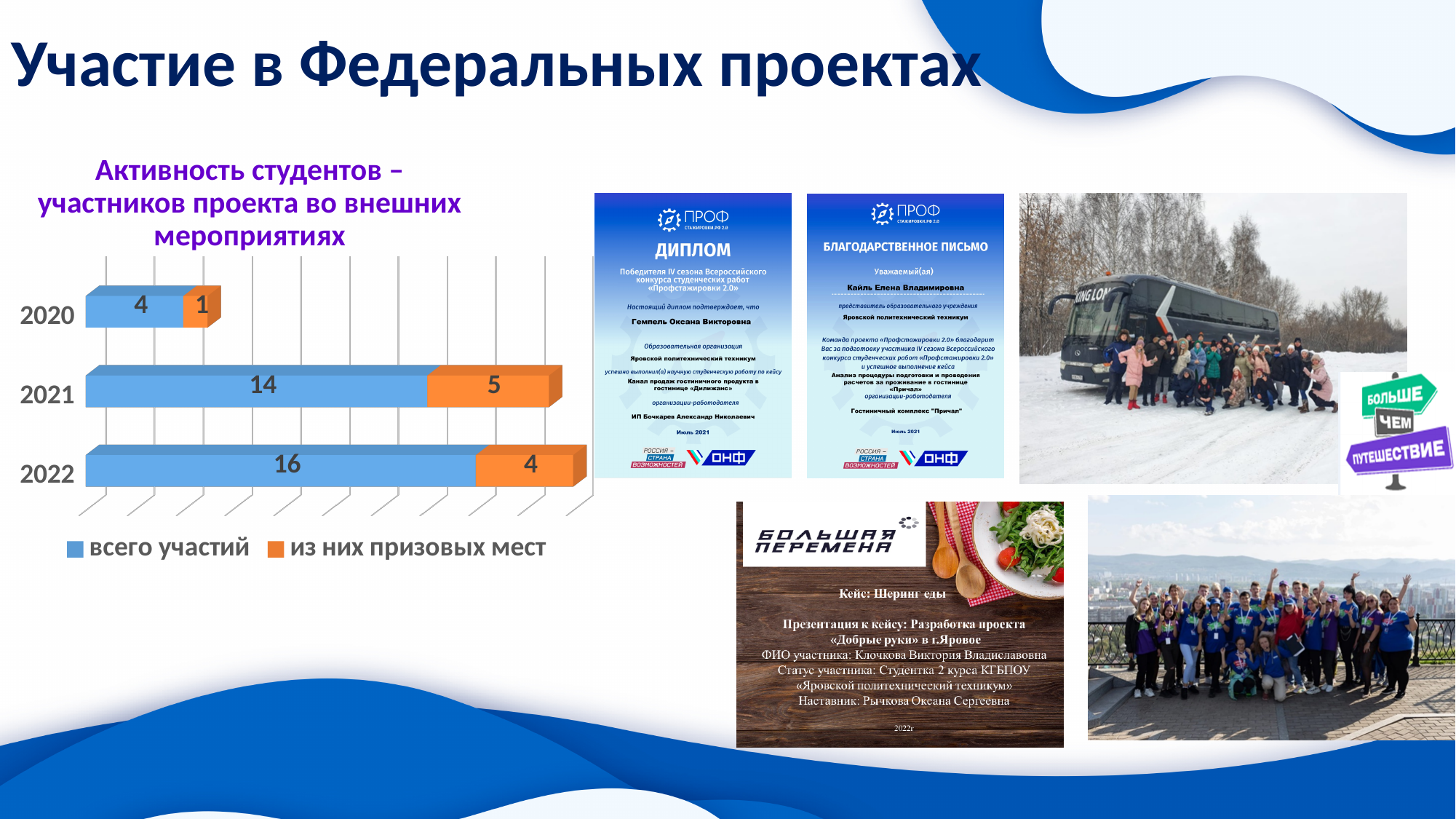
Which year has the highest value of «всего участий»? 2022 What type of chart is shown on the slide? bar chart What is the value of «из них призовых мест» for 2022? 4 Does the value of «всего участий» rise or fall from 2020 to 2022? rises How many years (categories) are shown in the chart? 3 Which is larger: «из них призовых мест» in 2021 or in 2022? 2021 Which year has the lowest value of «из них призовых мест»? 2020 What is the total of the stacked bar for 2021? 19 How many series does the chart legend list? 2 What is the value of «всего участий» for 2021? 14 What is the difference between «всего участий» in 2022 and in 2021? 2 What is the value of «всего участий» for 2020? 4